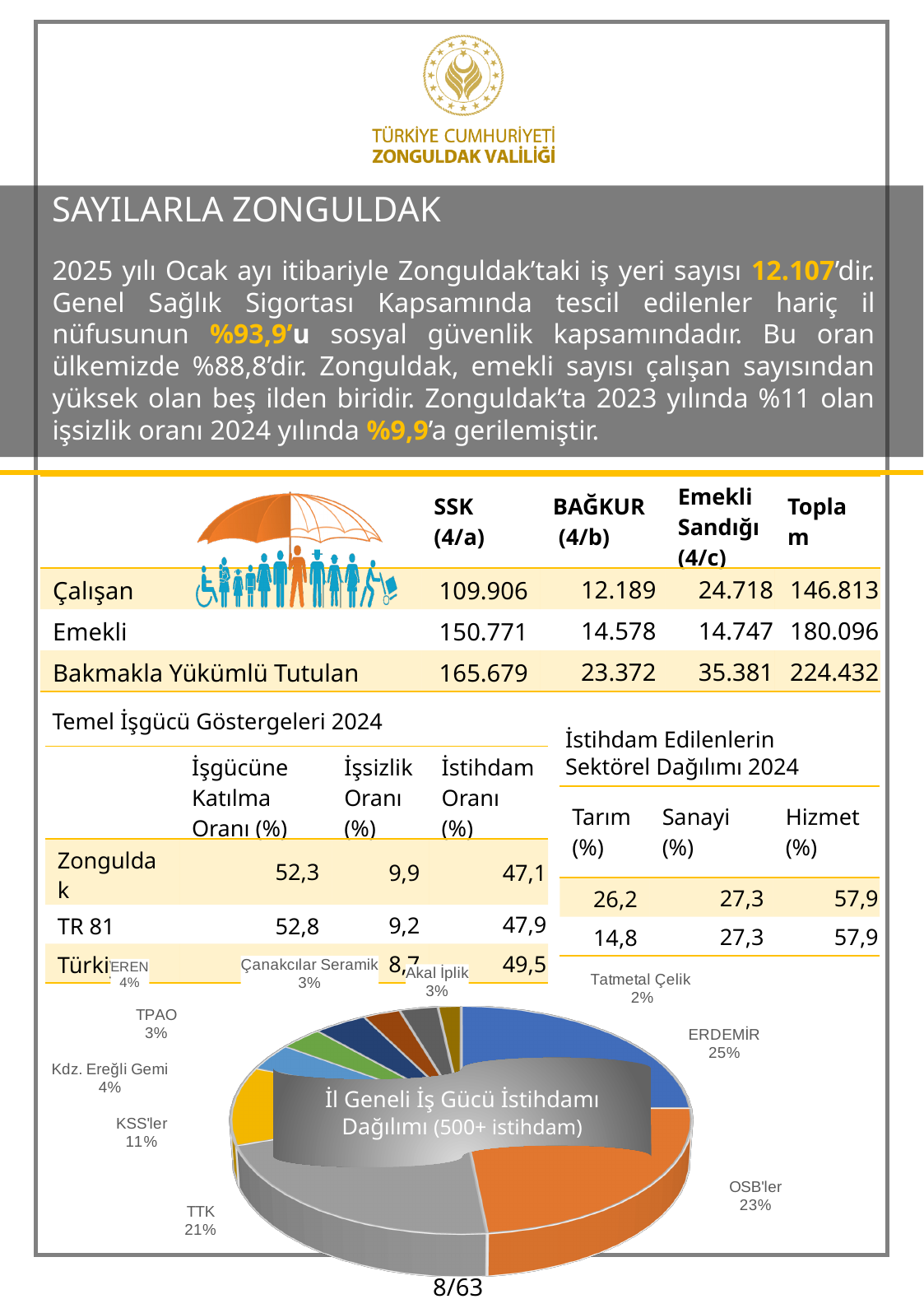
In the pie chart, what is the difference between the shares of ERDEMİR and OSB'ler? 2% How many slices does the pie chart have? 10 What kind of chart is shown at the bottom of the slide? pie chart Which slice of the pie chart is the largest? ERDEMİR Which slice of the pie chart is the smallest? Tatmetal Çelik In the pie chart, what share does ERDEMİR have? 25% In the pie chart, what share does TTK have? 21% In the pie chart, what share do KSS'ler have? 11% In the pie chart, which is larger: the share of OSB'ler or the share of TTK? OSB'ler What is the title of the pie chart? İl Geneli İş Gücü İstihdamı Dağılımı (500+ istihdam) In the pie chart, what share does Tatmetal Çelik have? 2% In the pie chart, what is the difference between the shares of KSS'ler and Kdz. Ereğli Gemi? 7%